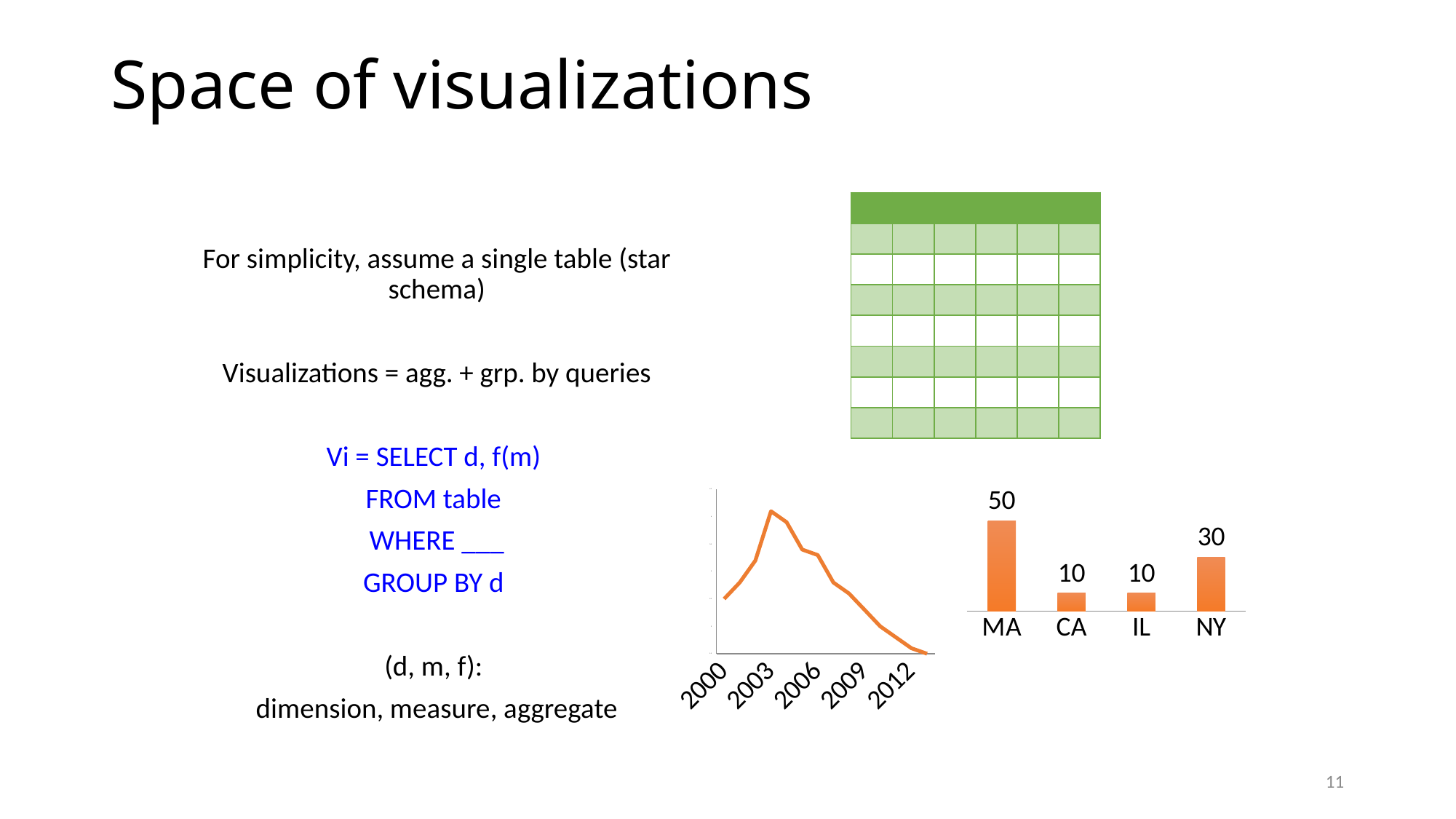
What kind of chart is the chart on the right with MA, CA, IL and NY? bar chart In the bar chart on the right, which category has the highest value? MA In the bar chart on the right, what is the value for NY? 30 In the bar chart on the right, what is the value for CA? 10 In the bar chart on the right, what is the difference between the values for NY and IL? 20 In the bar chart on the right, which is larger, the value for NY or the value for CA? NY In the line chart in the bottom middle, do the values rise or fall from 2006 to 2012? fall In the bar chart on the right, what is the value for MA? 50 How many categories are shown in the bar chart on the right? 4 How many year labels are shown on the x axis of the line chart in the bottom middle? 5 What kind of chart is the chart in the bottom middle with years 2000 to 2012 on the x axis? line chart In the bar chart on the right, what is the difference between the values for MA and NY? 20